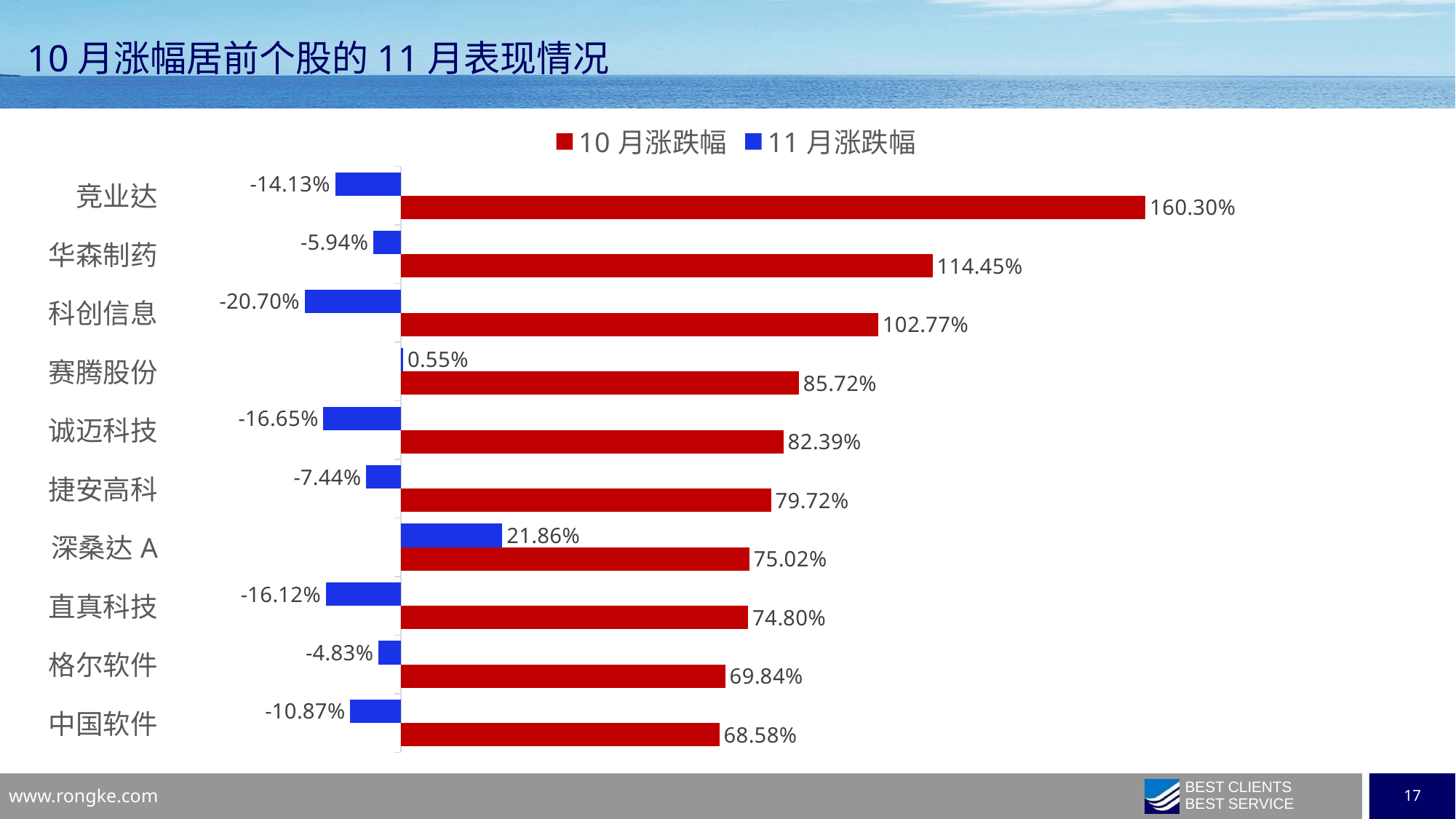
Which colour represents 11 月涨跌幅 in the chart? Blue What is the 11 月涨跌幅 value for 深桑达 A? 21.86% How many series does the legend list? 2 Which stock has the lowest 10 月涨跌幅? 中国软件 Which is larger, the 11 月涨跌幅 of 华森制药 or of 格尔软件? 格尔软件 What is the difference between the 10 月涨跌幅 of 竞业达 and 华森制药? 45.85% What is the 10 月涨跌幅 value for 竞业达? 160.30% Which stock has the lowest 11 月涨跌幅? 科创信息 How many stocks are shown in the chart? 10 What is the 11 月涨跌幅 value for 科创信息? -20.70% Which stock has the highest 10 月涨跌幅? 竞业达 What kind of chart is shown on the slide? Bar chart